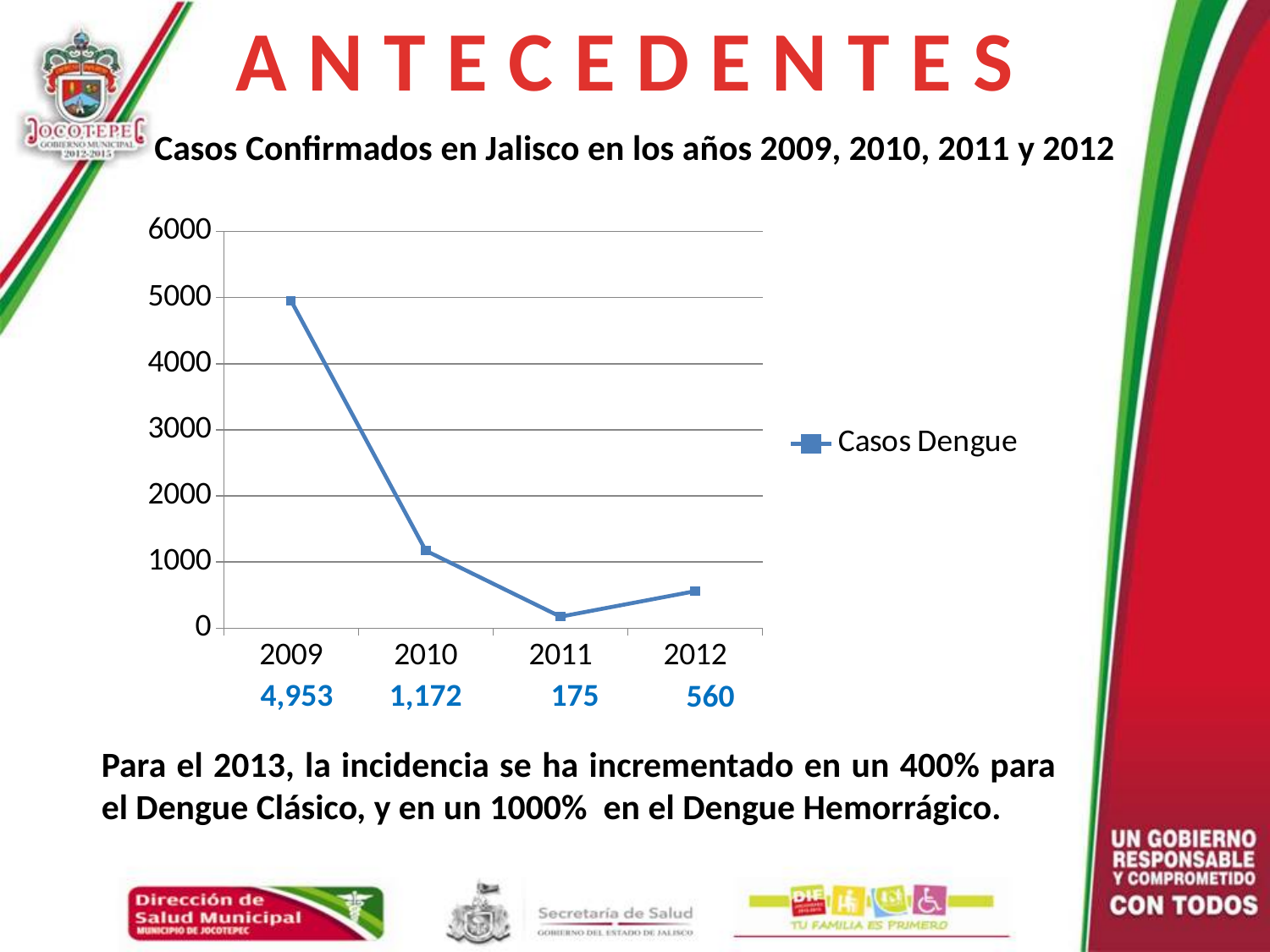
How many confirmed dengue cases were there in 2010? 1,172 Which year had the highest number of confirmed dengue cases? 2009 What type of chart is shown on the slide? line chart Which year had more confirmed dengue cases, 2011 or 2012? 2012 What is the name of the series shown in the chart legend? Casos Dengue How many confirmed dengue cases were there in 2011? 175 What is the difference in confirmed dengue cases between 2009 and 2010? 3,781 How many confirmed dengue cases were there in 2009? 4,953 How many years are plotted on the x axis of the chart? 4 How many series does the chart legend list? 1 Which year had the lowest number of confirmed dengue cases? 2011 How many confirmed dengue cases were there in 2012? 560